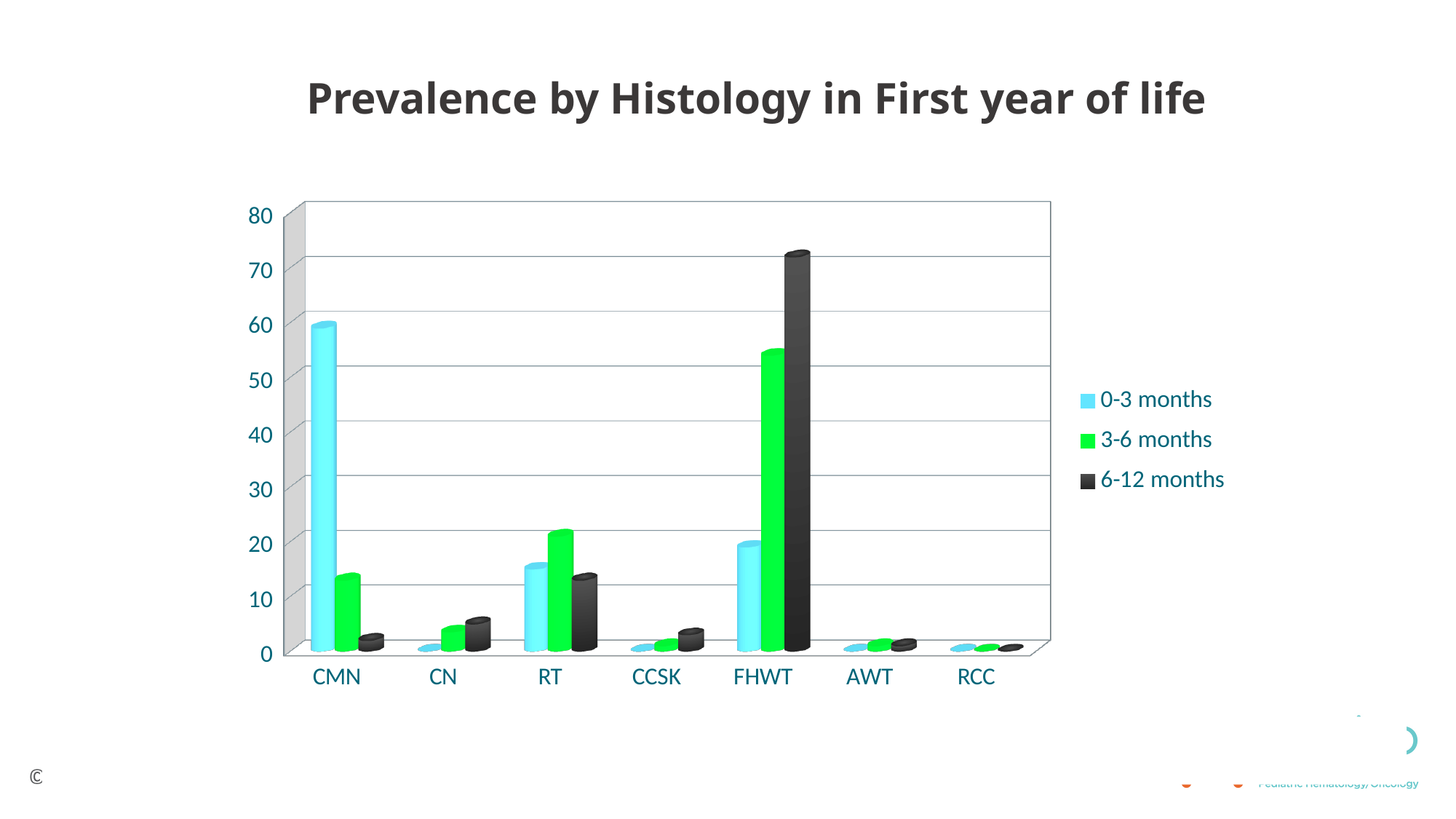
Which histology has the highest value for the 0-3 months series? CMN For FHWT, which is larger: the 3-6 months value or the 6-12 months value? 6-12 months For CMN, which is larger: the 0-3 months value or the 3-6 months value? 0-3 months How many series does the legend list? 3 What kind of chart is shown on the slide? bar chart Is the 3-6 months value for RT greater or less than 30? less Is the 6-12 months value for FHWT greater or less than 70? greater Which histology has the highest value for the 6-12 months series? FHWT Which histology has the highest value for the 3-6 months series? FHWT How many histology categories are shown on the x axis? 7 Is the 0-3 months value for CMN greater or less than 50? greater What is the title of the chart? Prevalence by Histology in First year of life